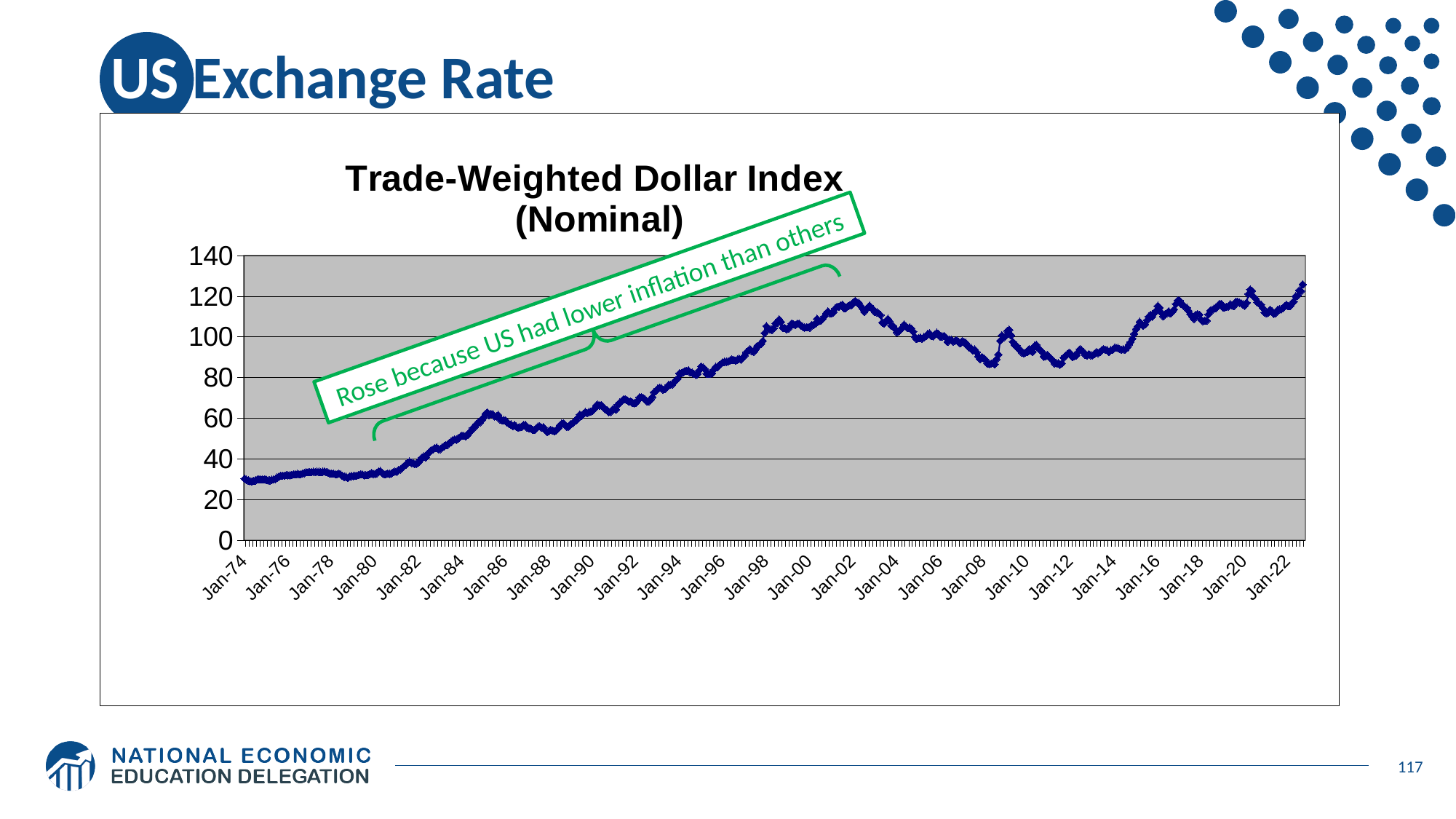
What does the green annotation on the chart say? Rose because US had lower inflation than others Is the value of the index at Jan-90 greater or less than 80? less Is the value of the index at Jan-02 greater or less than 100? greater What is the title of the chart? Trade-Weighted Dollar Index (Nominal) Is the value of the index at Jan-74 greater or less than 40? less Overall, does the index rise or fall from Jan-74 to the end of the series? rise What kind of chart is shown on the slide? line chart Which is higher, the index value at Jan-02 or at Jan-74? Jan-02 Which is higher, the index value at Jan-02 or at Jan-08? Jan-02 What is the highest value shown on the vertical axis? 140